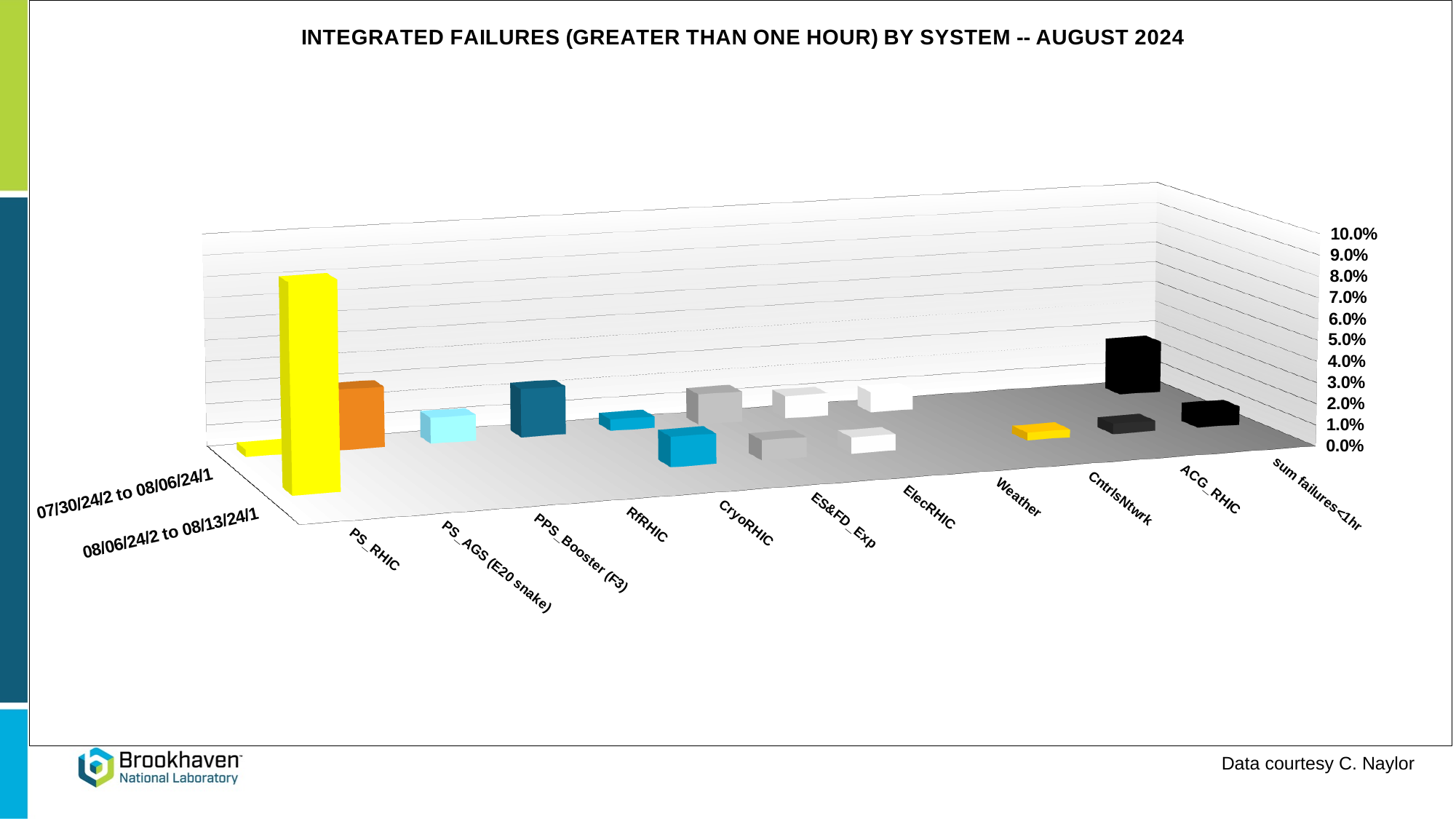
Which is larger in the 07/30/24/2 to 08/06/24/1 period, the bar for sum failures<1hr or the bar for ACG_RHIC? sum failures<1hr What is the highest tick value shown on the vertical axis? 10.0% How many system categories are shown along the x axis of the chart? 11 Which is larger in the 08/06/24/2 to 08/13/24/1 period, the bar for PS_RHIC or the bar for PS_AGS (E20 snake)? PS_RHIC What kind of chart is shown on the slide? bar chart What is the title of the chart? INTEGRATED FAILURES (GREATER THAN ONE HOUR) BY SYSTEM -- AUGUST 2024 Which system has the tallest bar in the chart? PS_RHIC What are the two time periods labelled on the depth axis of the chart? 07/30/24/2 to 08/06/24/1 and 08/06/24/2 to 08/13/24/1 Is the value for PS_AGS (E20 snake) in the 07/30/24/2 to 08/06/24/1 period greater or less than 5.0%? less Is the value for PS_RHIC in the 08/06/24/2 to 08/13/24/1 period greater or less than 5.0%? greater How many time periods (rows) are plotted in the chart? 2